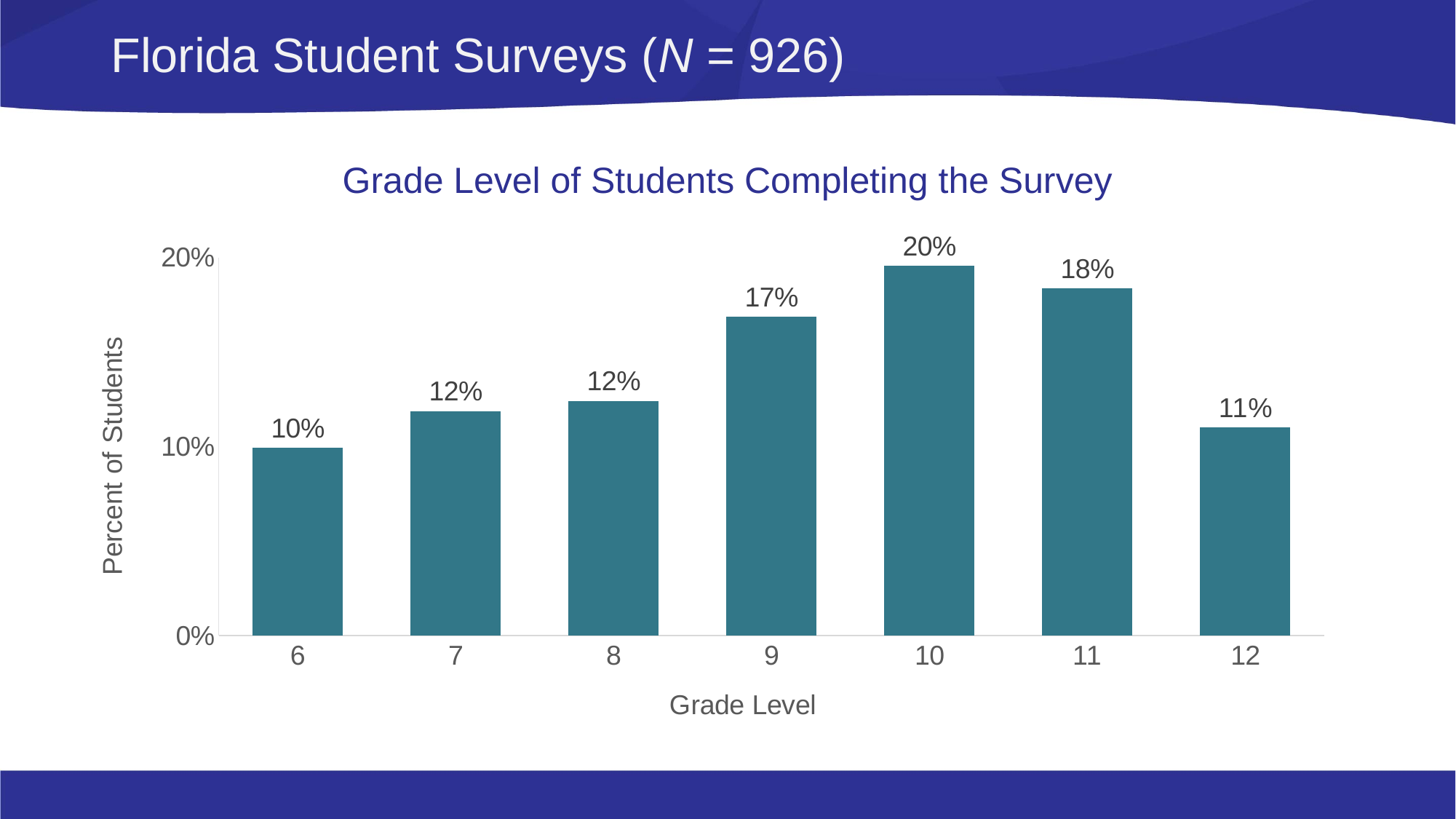
Which has a larger percent of students, grade 9 or grade 12? Grade 9 What is the difference in percent of students between grade 11 and grade 9? 1% Which grade level has the highest percent of students? 10 What percent of students completing the survey were in grade 12? 11% What is the difference in percent of students between grade 10 and grade 6? 10% What is the title of the chart? Grade Level of Students Completing the Survey Which grade level has the lowest percent of students? 6 Is the value for grade 11 greater or less than 10%? greater What percent of students completing the survey were in grade 10? 20% What kind of chart is shown on the slide? Bar chart How many grade levels are shown on the chart? 7 What percent of students completing the survey were in grade 6? 10%